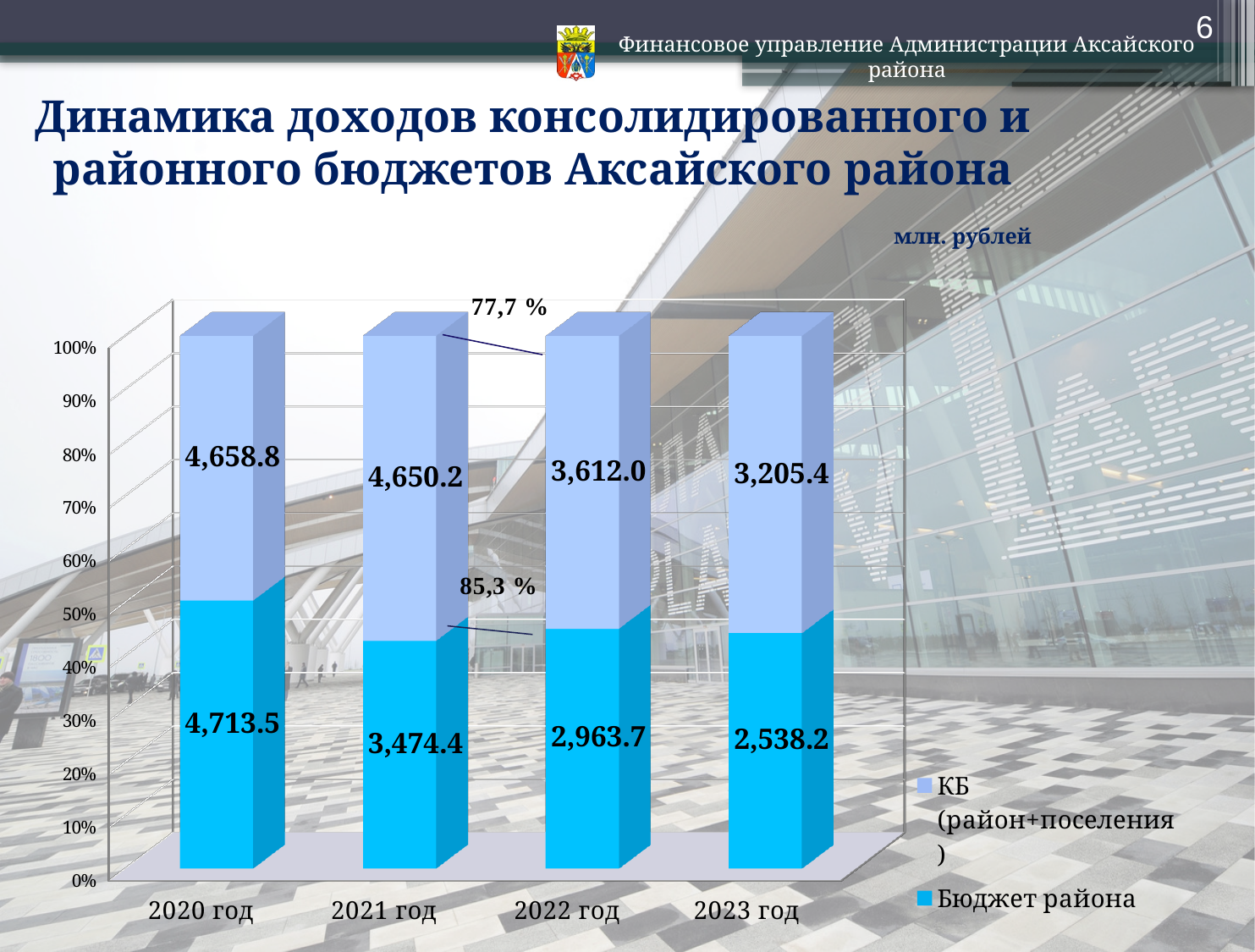
What is the value for Бюджет района in 2020 год? 4,713.5 What is the difference between the КБ (район+поселения) values for 2020 год and 2021 год? 8.6 How many series does the legend list? 2 How many years are shown on the x axis? 4 What kind of chart is shown on the slide? Stacked bar chart What is the value for КБ (район+поселения) in 2021 год? 4,650.2 Do the Бюджет района values rise or fall from 2020 год to 2023 год? Fall What is the value for КБ (район+поселения) in 2022 год? 3,612.0 Which is larger: the Бюджет района value for 2021 год or for 2022 год? 2021 год Which year has the highest value for Бюджет района? 2020 год What is the value for Бюджет района in 2023 год? 2,538.2 Which year has the lowest value for КБ (район+поселения)? 2023 год